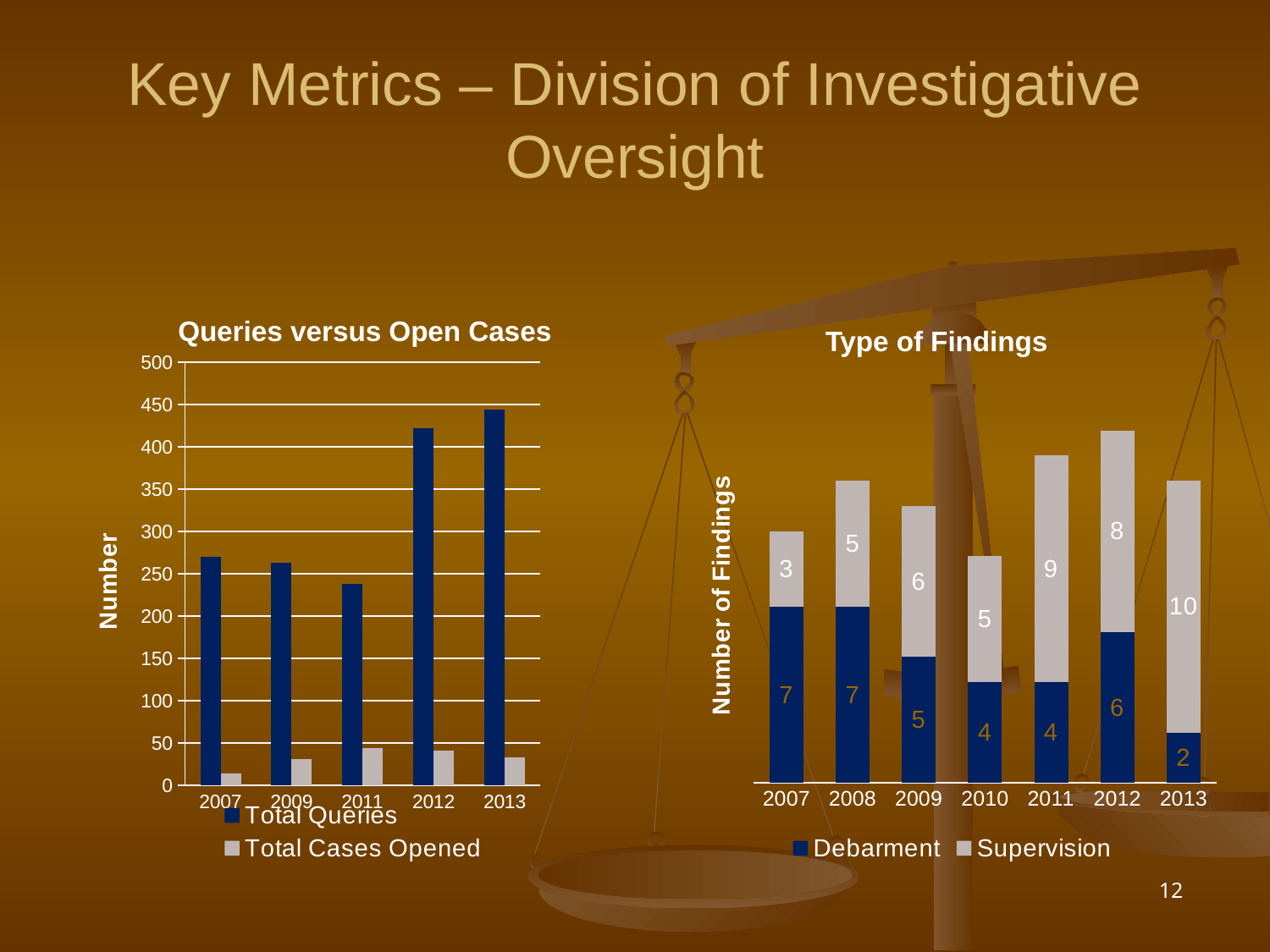
In the 'Type of Findings' chart, what is the difference between the Supervision and Debarment values for 2011? 5 In the 'Queries versus Open Cases' chart, which year has the lowest Total Queries value? 2011 In the 'Type of Findings' chart, how many years are shown on the x axis? 7 In the 'Type of Findings' chart, what is the Supervision value for 2013? 10 In the 'Type of Findings' chart, which year has the lowest Debarment value? 2013 In the 'Type of Findings' chart, what is the total of the stacked bar for 2012? 14 How many series does the legend of the 'Queries versus Open Cases' chart list? 2 In the 'Type of Findings' chart, what is the Debarment value for 2007? 7 In the 'Type of Findings' chart, is the Debarment value for 2008 larger or smaller than the Supervision value for 2008? larger In the 'Queries versus Open Cases' chart, which year has the highest Total Queries value? 2013 In the 'Queries versus Open Cases' chart, is the Total Queries value for 2012 greater or less than 400? greater In the 'Type of Findings' chart, which year has the highest Supervision value? 2013